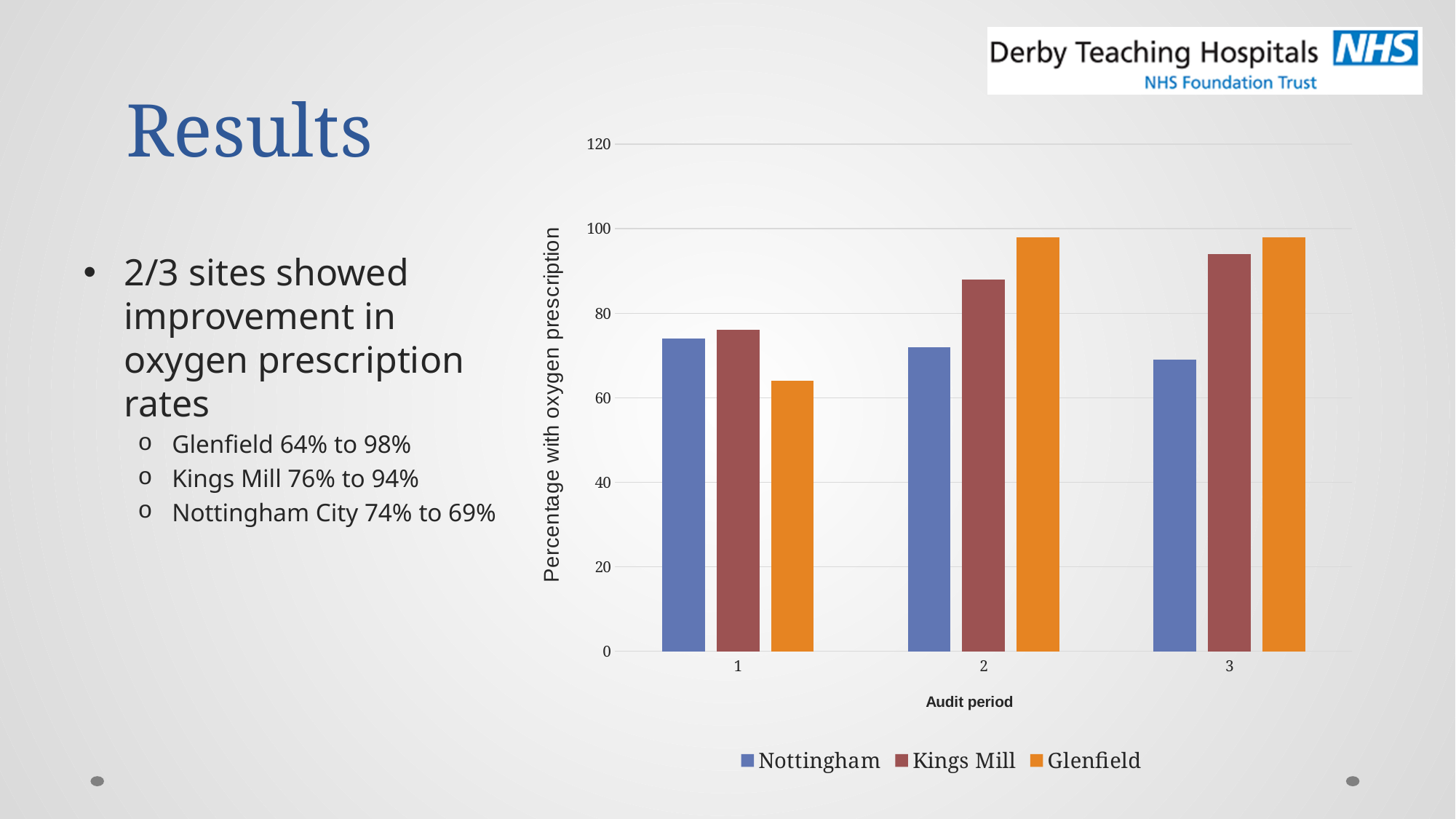
How many series does the legend list? 3 How many audit periods are shown on the x axis? 3 What is the title of the y axis? Percentage with oxygen prescription Is the value for Nottingham in audit period 3 greater or less than 80? less Which site has the lowest bar in audit period 3? Nottingham Which site has the highest bar in audit period 2? Glenfield Is the value for Glenfield in audit period 1 greater or less than 80? less In audit period 2, which is larger: Kings Mill or Nottingham? Kings Mill Is the value for Kings Mill in audit period 3 greater or less than 80? greater Do the Glenfield values rise or fall from audit period 1 to audit period 3? rise Which site has the lowest bar in audit period 1? Glenfield What kind of chart is shown on the slide? bar chart